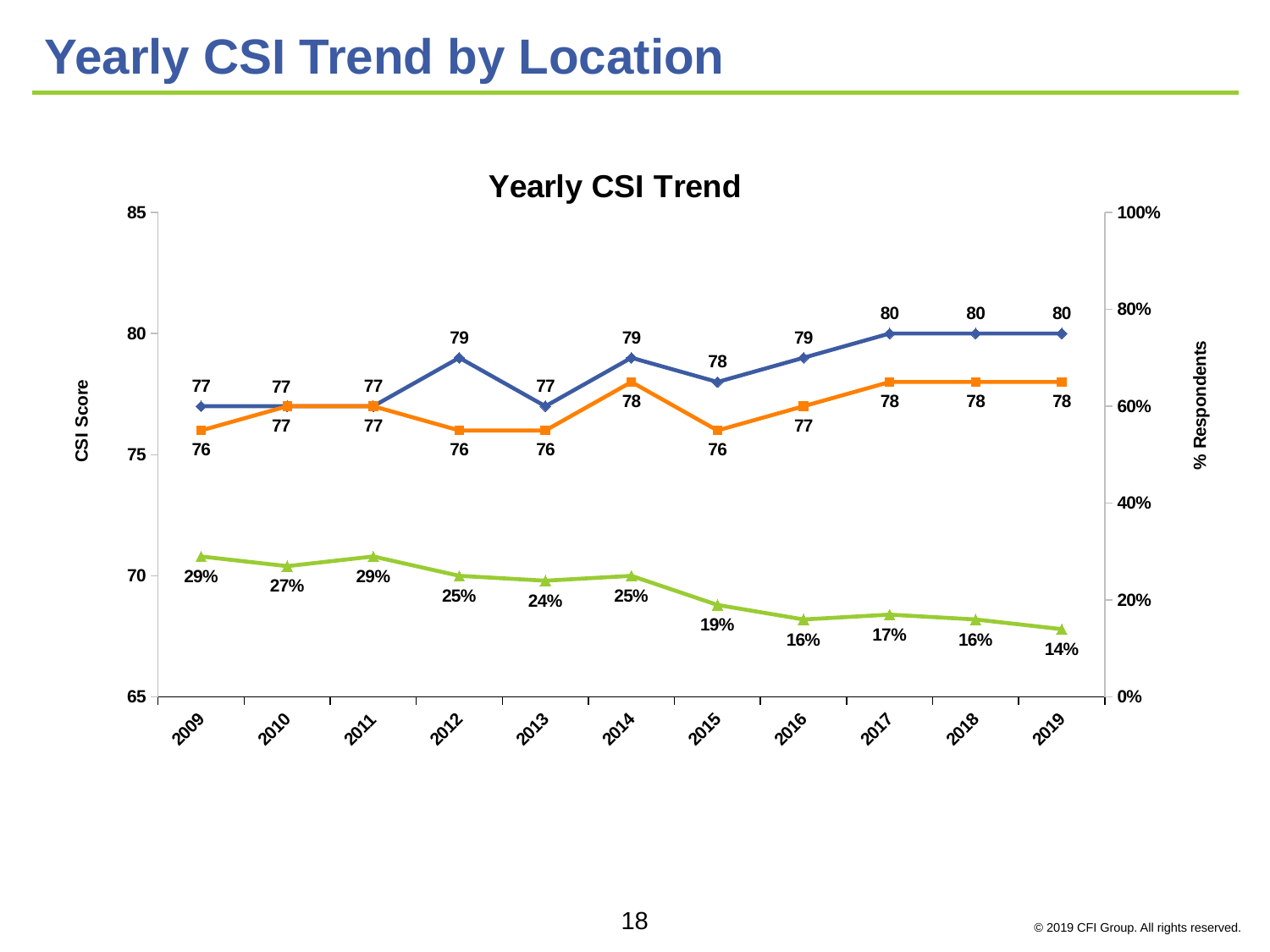
Does the green % Respondents line generally rise or fall from 2009 to 2019? fall Which is larger in 2013, the blue line value or the orange line value? blue line What is the difference between the blue line and the orange line in 2015? 2 What is the difference between the green line's value in 2009 and its value in 2019? 15% What is the highest value reached by the blue line? 80 How many years are plotted along the x axis? 11 In which year does the green % Respondents line reach its lowest value? 2019 What is the value of the blue line in 2012? 79 What type of chart is shown on the slide? line chart What is the value of the orange line in 2014? 78 What is the chart title? Yearly CSI Trend What is the % Respondents value (green line) in 2019? 14%